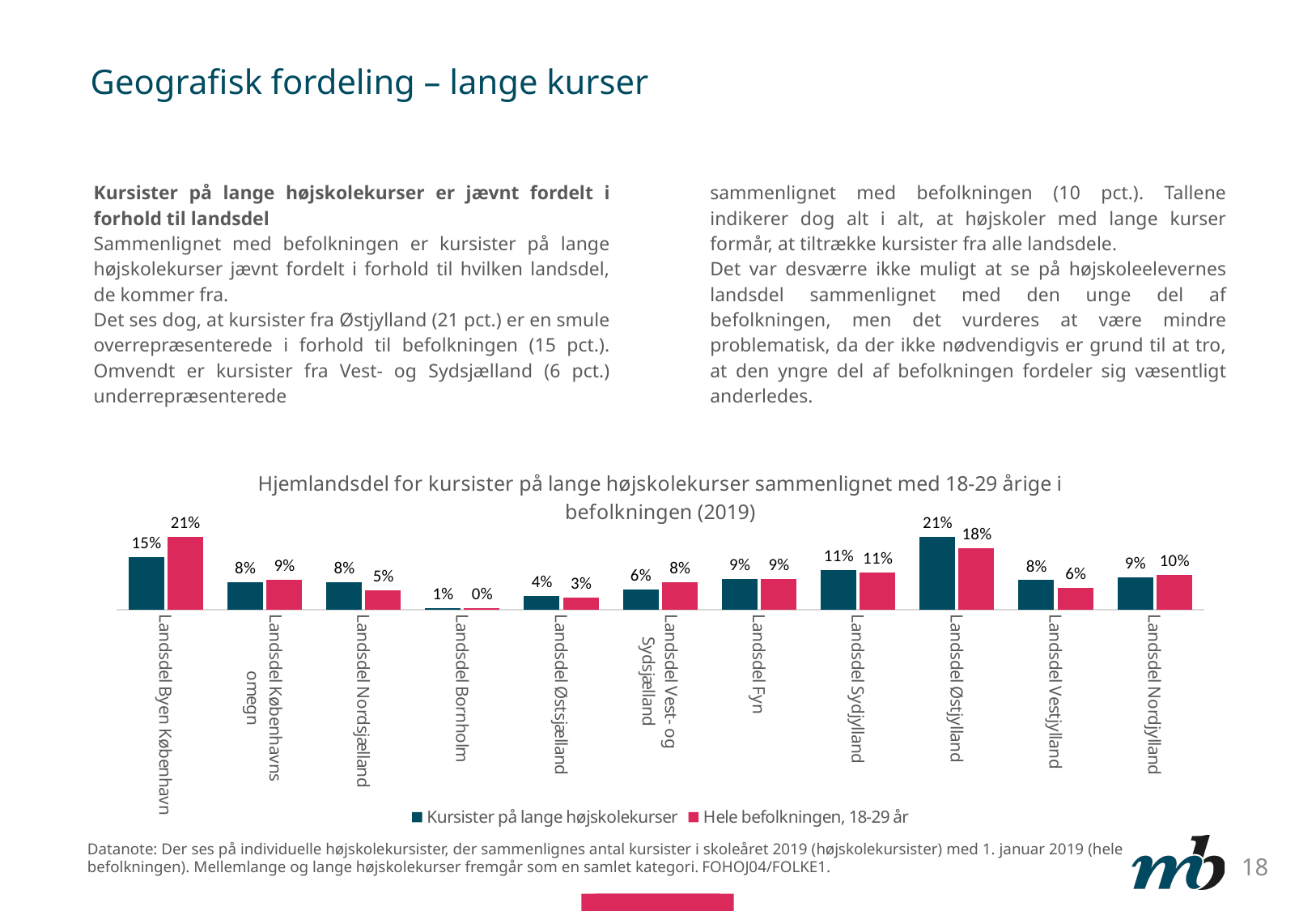
How many categories (landsdele) are shown on the x axis? 11 Which category has the highest value in the series 'Kursister på lange højskolekurser'? Landsdel Østjylland How many series does the legend list? 2 For Landsdel Nordsjælland, which series has the larger value? Kursister på lange højskolekurser What is the difference between the two series for Landsdel Byen København? 6% Which category has the lowest value in the series 'Hele befolkningen, 18-29 år'? Landsdel Bornholm What is the value for Landsdel Vest- og Sydsjælland in the series 'Kursister på lange højskolekurser'? 6% What is the value for Landsdel Bornholm in the series 'Hele befolkningen, 18-29 år'? 0% What is the value for Landsdel Østjylland in the series 'Kursister på lange højskolekurser'? 21% What is the value for Landsdel Byen København in the series 'Hele befolkningen, 18-29 år'? 21% What is the difference between the two series for Landsdel Østjylland? 3% What kind of chart is shown on the slide? Bar chart